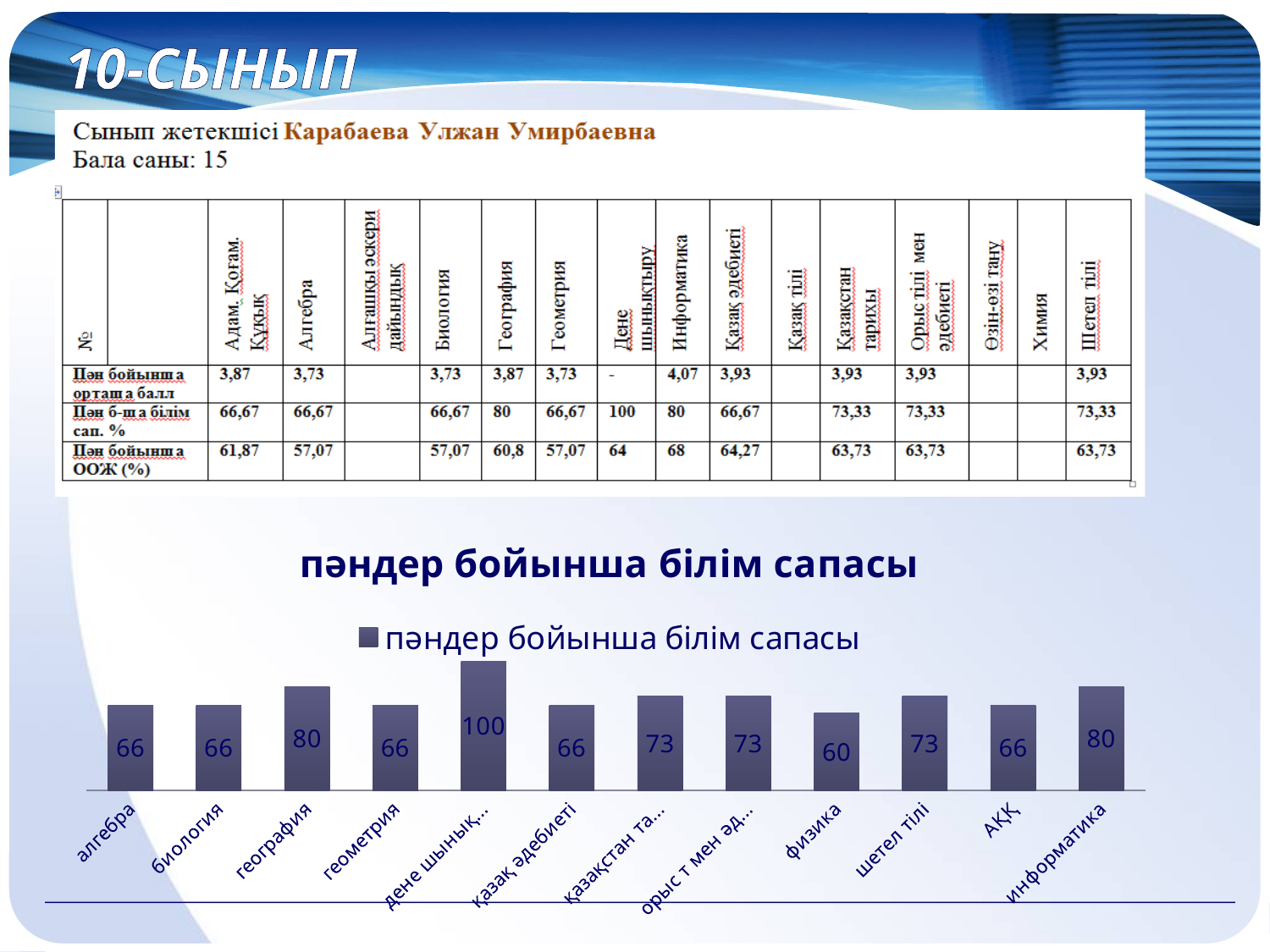
What is the value for физика in the chart? 60 What is the value for география in the chart? 80 What is the value for информатика in the chart? 80 What is the difference between the values for география and физика? 20 Which category has the lowest value in the chart? физика What kind of chart is shown on the slide? bar chart What is the title of the chart? пәндер бойынша білім сапасы What is the value for шетел тілі in the chart? 73 Which is larger, the value for шетел тілі or the value for АҚҚ? шетел тілі How many series does the chart legend list? 1 Which category has the highest value in the chart? дене шынықтыру How many categories are shown in the chart? 12